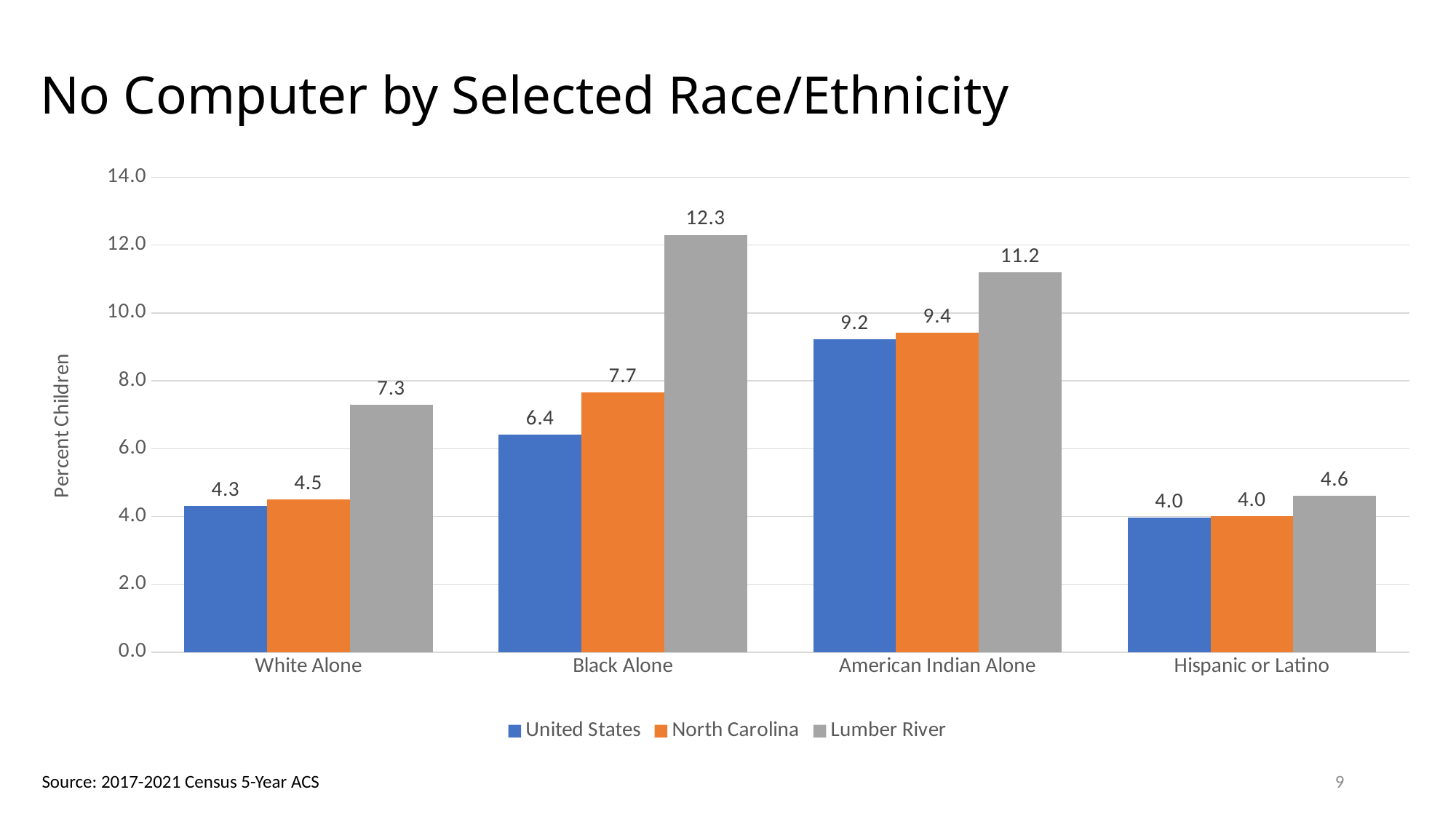
What is the label of the vertical axis? Percent Children What is the United States value for American Indian Alone? 9.2 What is the difference between the Lumber River and North Carolina values for Black Alone? 4.6 What is the Lumber River value for Black Alone? 12.3 What is the North Carolina value for White Alone? 4.5 Which category has the lowest United States value? Hispanic or Latino Which is larger for American Indian Alone: the North Carolina value or the Lumber River value? Lumber River How many series does the legend list? 3 Is the Lumber River value for American Indian Alone greater or less than 10.0? greater How many race/ethnicity categories are shown on the x axis? 4 What kind of chart is shown on the slide? bar chart Which category has the highest Lumber River value? Black Alone